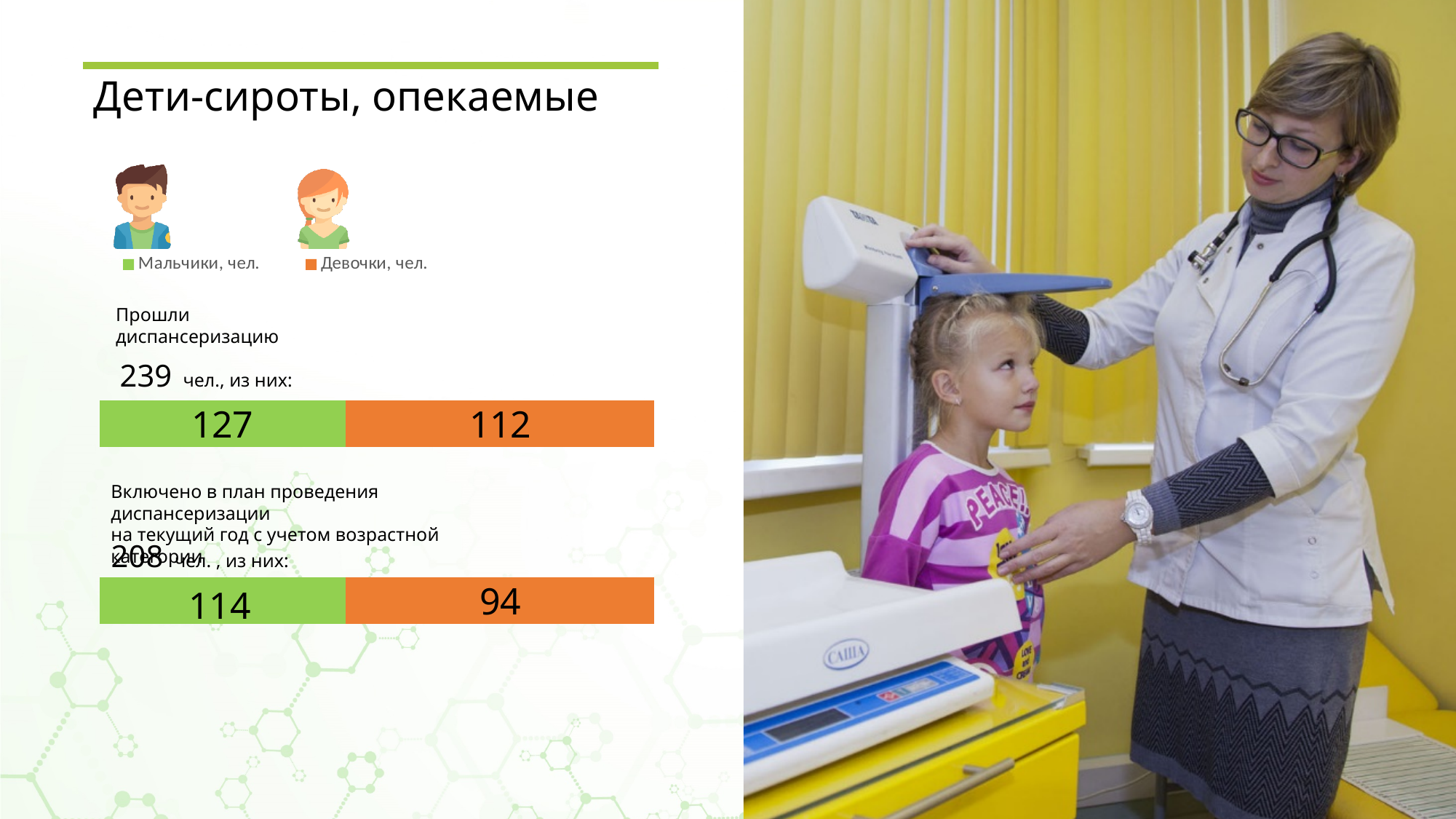
In the bar for "Прошли диспансеризацию", what is the value for Мальчики? 127 What kind of chart is shown on the slide? Stacked bar chart In the bar for "Включено в план проведения диспансеризации", what is the difference between Мальчики and Девочки? 20 In the bar for "Прошли диспансеризацию", what is the value for Девочки? 112 In the bar for "Включено в план проведения диспансеризации", what is the value for Девочки? 94 In the bar for "Включено в план проведения диспансеризации", what is the value for Мальчики? 114 What is the total of the stacked bar for "Прошли диспансеризацию"? 239 How many series does the legend list? 2 In the bar for "Включено в план проведения диспансеризации", which is larger, Мальчики or Девочки? Мальчики What is the total of the stacked bar for "Включено в план проведения диспансеризации"? 208 Which colour represents Девочки in the legend? Orange In the bar for "Прошли диспансеризацию", what is the difference between Мальчики and Девочки? 15